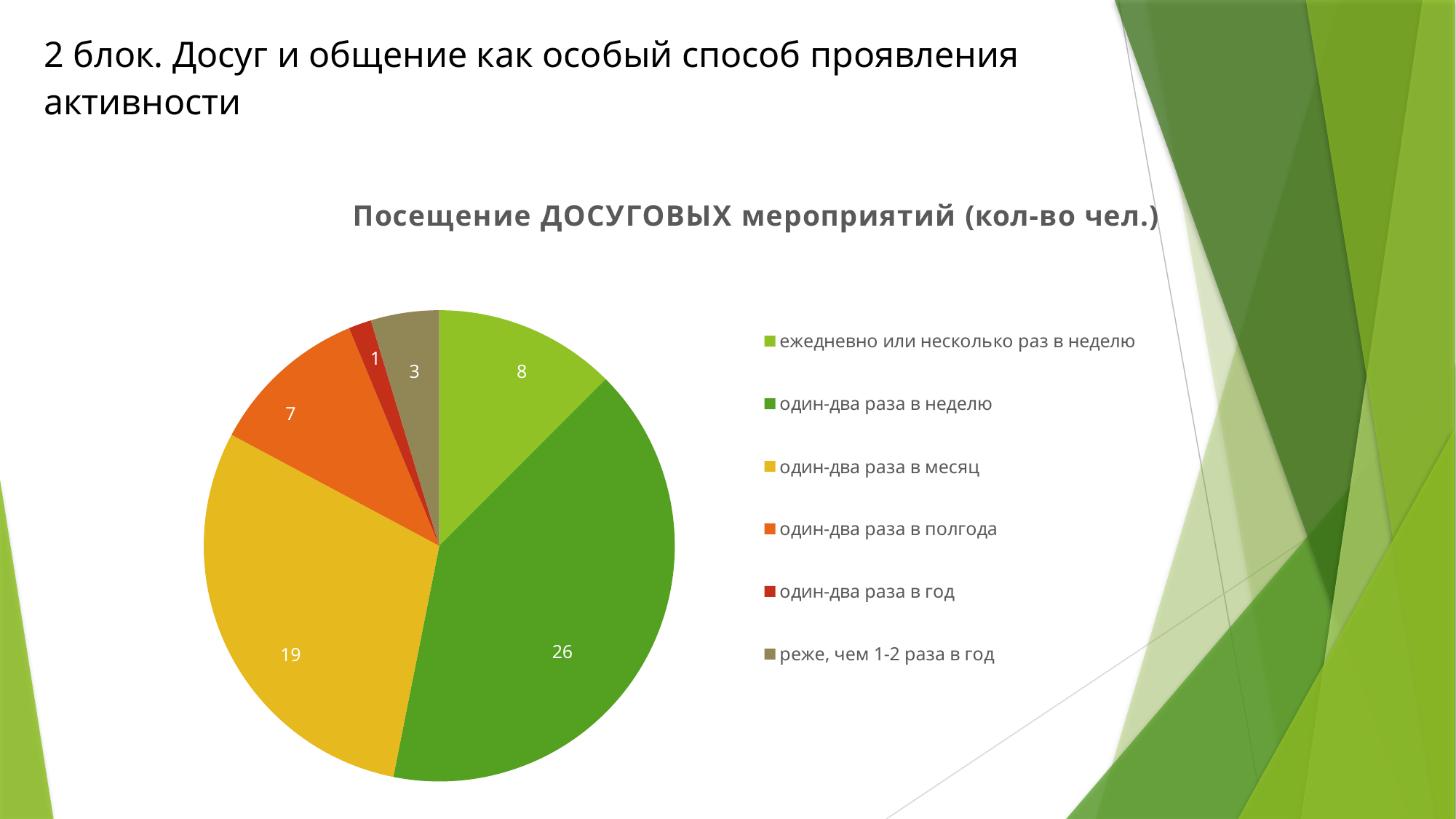
What is the title of the chart? Посещение ДОСУГОВЫХ мероприятий (кол-во чел.) What is the value for "реже, чем 1-2 раза в год"? 3 What is the value for "ежедневно или несколько раз в неделю"? 8 What share of the pie does "ежедневно или несколько раз в неделю" represent? 12.5% What is the value for "один-два раза в неделю"? 26 What is the difference between the values for "один-два раза в неделю" and "один-два раза в месяц"? 7 How many categories does the legend of the pie chart list? 6 Which is larger: the value for "один-два раза в полгода" or the value for "ежедневно или несколько раз в неделю"? ежедневно или несколько раз в неделю What is the value for "один-два раза в месяц"? 19 What type of chart is shown on the slide? pie chart Which category has the largest slice of the pie? один-два раза в неделю Which category has the smallest slice of the pie? один-два раза в год